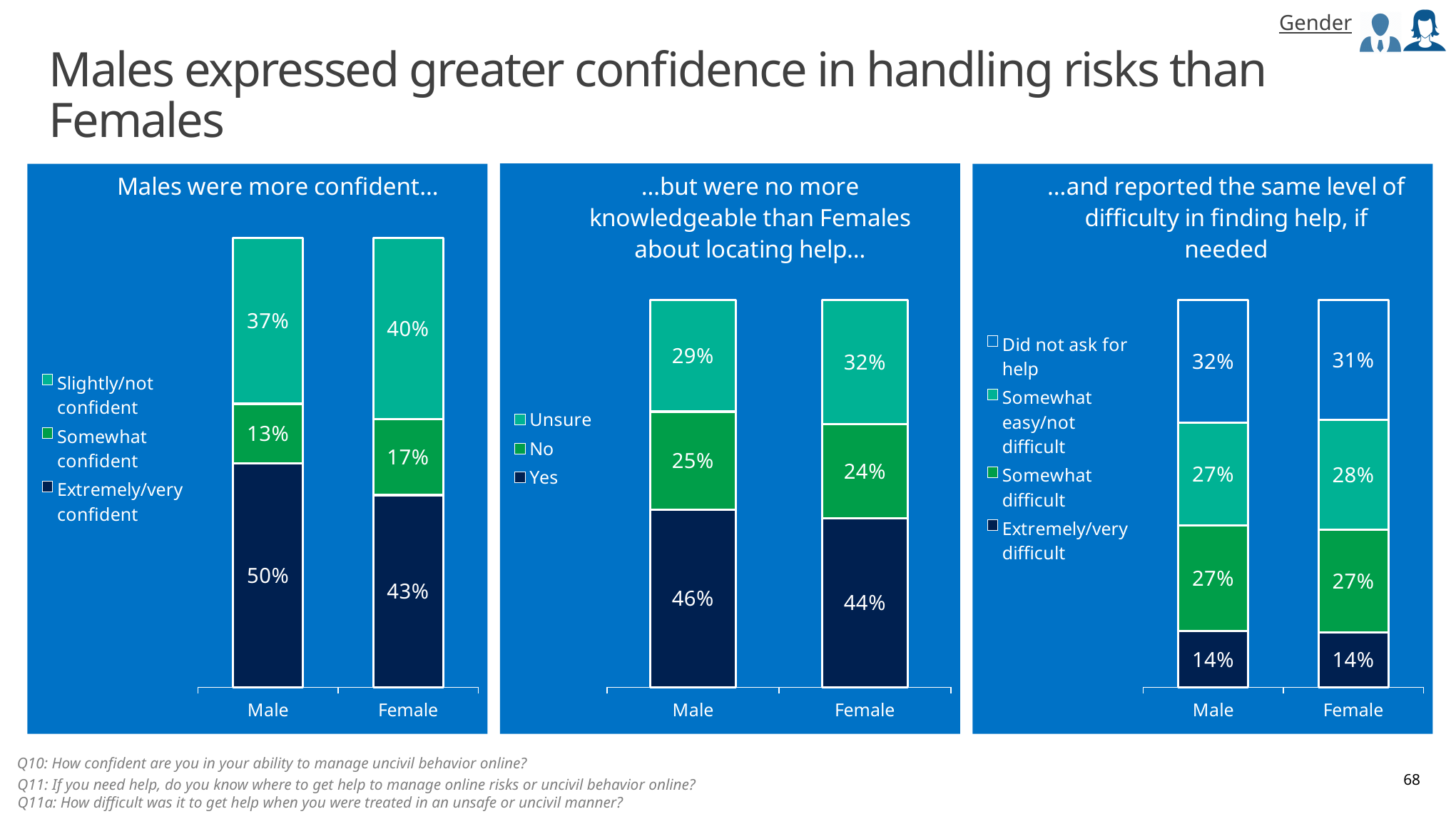
In the middle chart about locating help, what percentage of Females answered Unsure? 32% In the chart titled "Males were more confident...", what is the difference between the Male and Female Extremely/very confident percentages? 7% In the chart titled "Males were more confident...", which group has the larger Slightly/not confident share, Male or Female? Female In the right-hand chart about difficulty in finding help, how many series does the legend list? 4 What type of chart is used in the left-hand chart titled "Males were more confident..."? Stacked bar chart In the middle chart about locating help, what percentage of Males answered Yes? 46% In the right-hand chart about difficulty in finding help, what percentage of Females said it was Extremely/very difficult? 14% In the right-hand chart about difficulty in finding help, what percentage of Males Did not ask for help? 32% In the chart titled "Males were more confident...", what percentage of Males were Extremely/very confident? 50% In the chart titled "Males were more confident...", what percentage of Females were Somewhat confident? 17% In the middle chart about locating help, how many series does the legend list? 3 In the middle chart about locating help, what is the total of the Male stacked bar? 100%